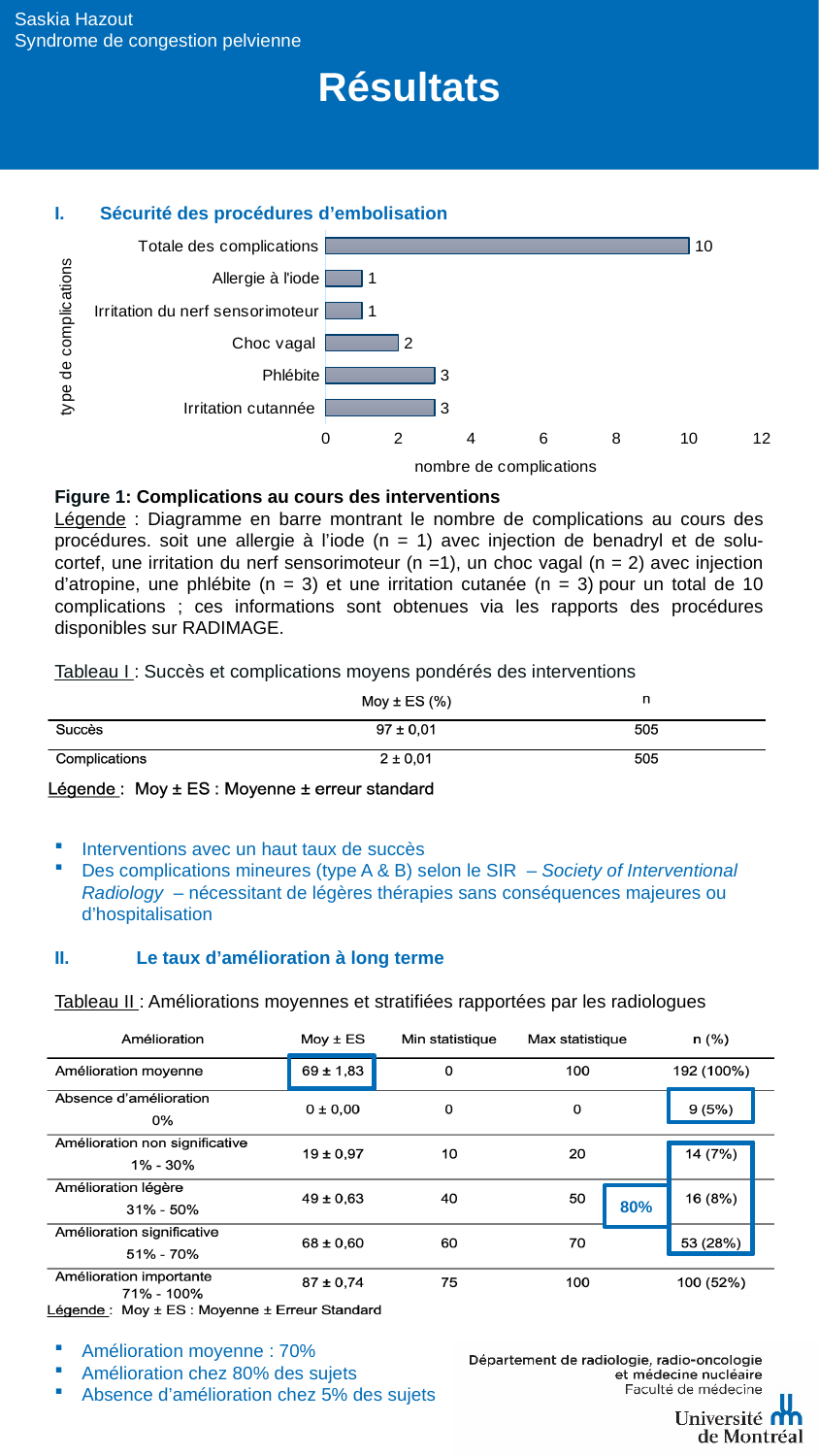
Which category has the highest value in the bar chart? Totale des complications What is the label of the horizontal axis of the bar chart? nombre de complications What is the value for Allergie à l'iode in the bar chart? 1 How many categories are shown in the bar chart? 6 What is the value for Phlébite in the bar chart? 3 What is the value for Totale des complications in the bar chart? 10 Which is larger in the bar chart, the value for Irritation cutannée or the value for Choc vagal? Irritation cutannée What is the difference between the values for Totale des complications and Phlébite in the bar chart? 7 Is the value for Totale des complications in the bar chart greater or less than 8? greater What kind of chart is shown under 'Sécurité des procédures d'embolisation'? bar chart What is the difference between the values for Choc vagal and Irritation du nerf sensorimoteur in the bar chart? 1 What is the value for Choc vagal in the bar chart? 2